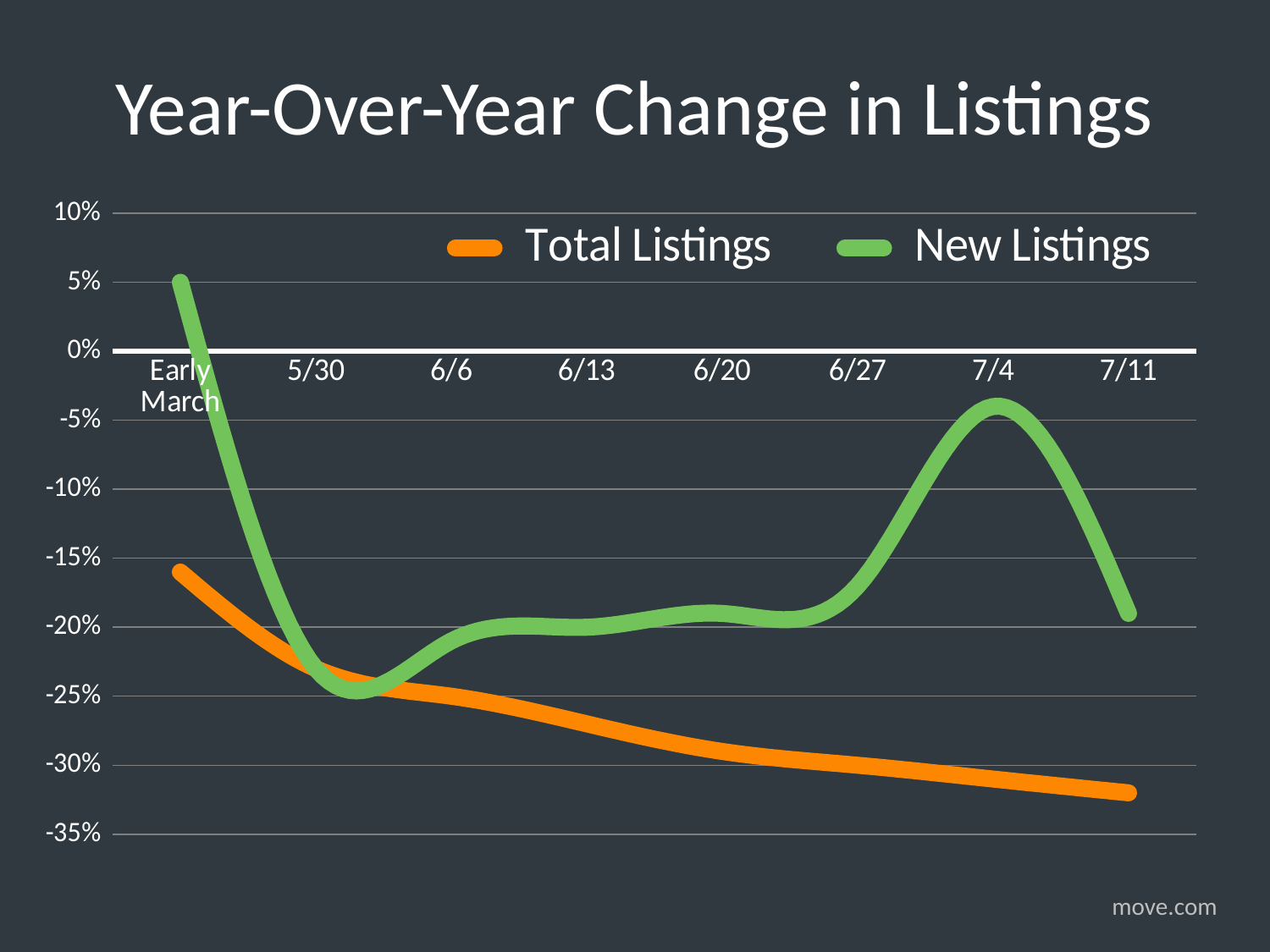
What colour is the New Listings line? green How many dates are labelled along the x axis? 8 Is the value for New Listings at 7/4 greater or less than -10%? greater At 7/4, which series has the higher value, Total Listings or New Listings? New Listings Is the value for New Listings at Early March greater or less than 0%? greater How many series does the legend list? 2 What is the title of the chart? Year-Over-Year Change in Listings Does the Total Listings line rise or fall from Early March to 7/11? fall Is the value for Total Listings at 7/11 greater or less than -30%? less At which date does the New Listings line reach its highest value? Early March What kind of chart is shown on the slide? line chart At which date does the Total Listings line reach its lowest value? 7/11